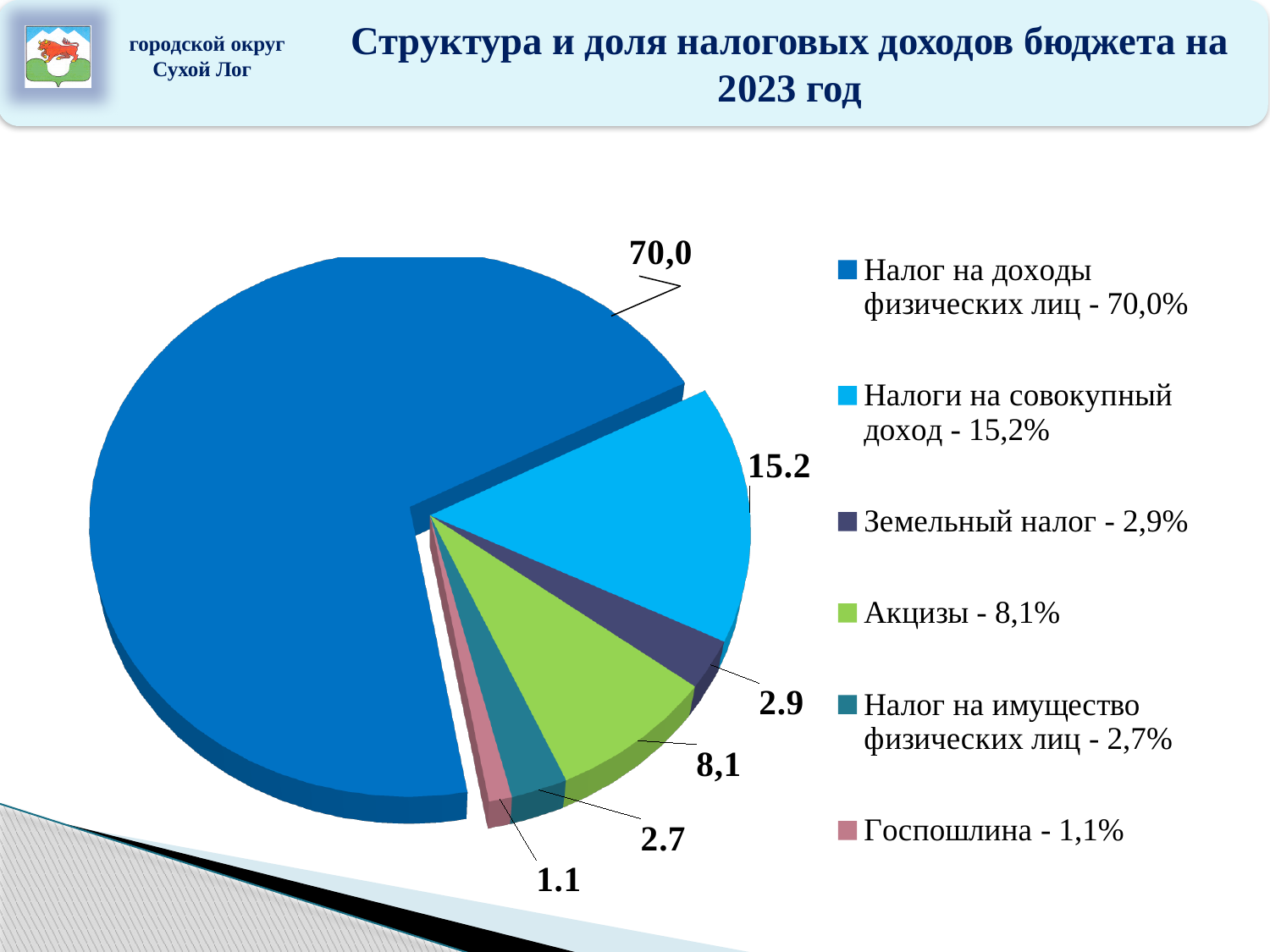
What is the title of the slide containing the chart? Структура и доля налоговых доходов бюджета на 2023 год What is the difference in percentage points between Налог на доходы физических лиц and Налоги на совокупный доход? 54,8 How many entries does the legend list? 6 What share is shown for Акцизы? 8,1% What kind of chart is shown on the slide? Pie chart Which is larger: the share of Земельный налог or the share of Налог на имущество физических лиц? Земельный налог Which category has the smallest share of the pie? Госпошлина What share is shown for Налоги на совокупный доход? 15,2% What share of tax revenues is Налог на доходы физических лиц? 70,0% What share is shown for Госпошлина? 1,1% Which category has the largest share of the pie? Налог на доходы физических лиц How many slices does the pie chart have? 6